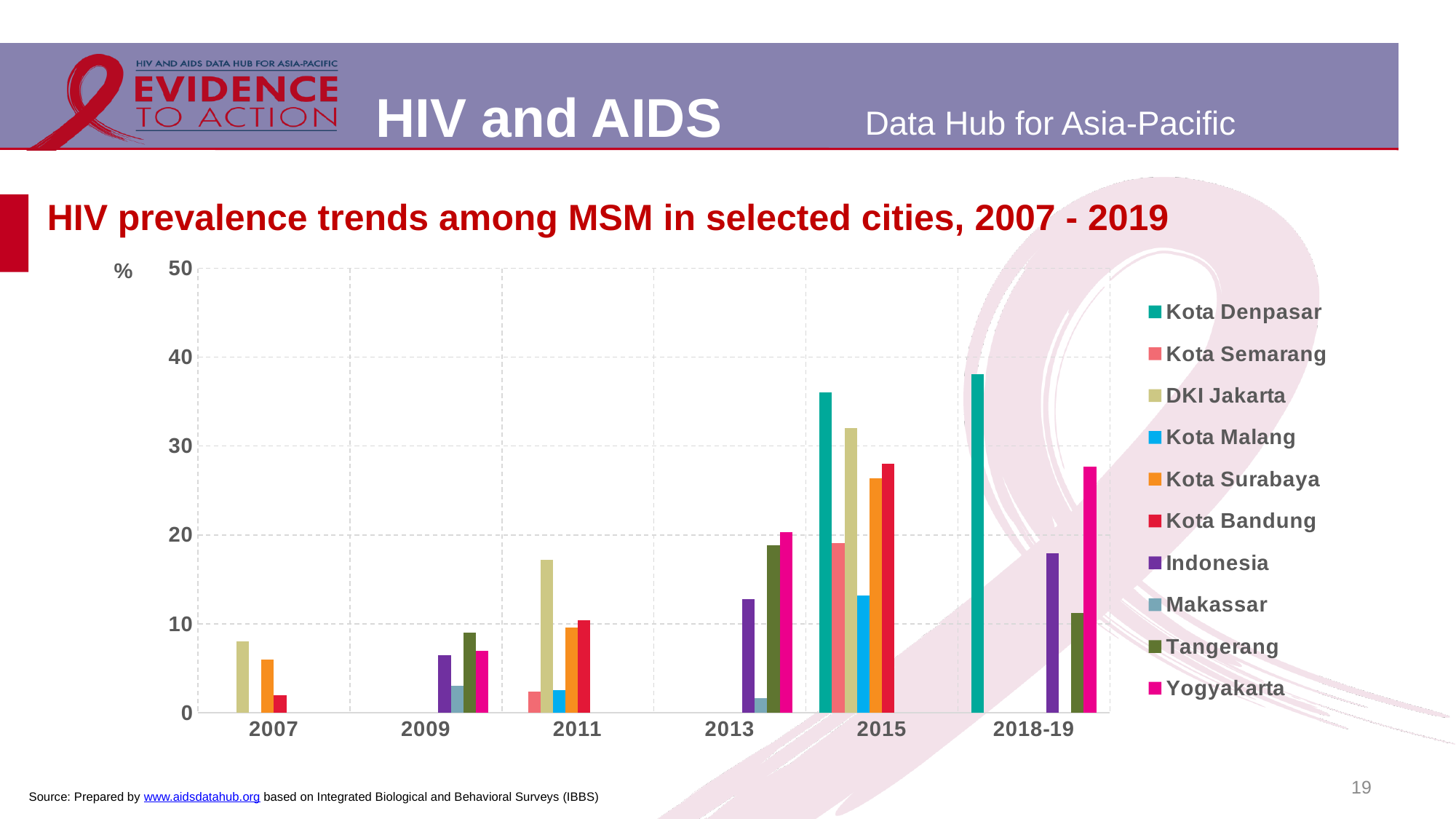
What kind of chart is shown on the slide? Bar chart Does the value for Kota Denpasar rise or fall from 2015 to 2018-19? Rise Is the value for DKI Jakarta in 2011 greater or less than 10? greater Is the value for Kota Malang in 2015 greater or less than 20? less Which city has the highest HIV prevalence in 2015? Kota Denpasar What is the title of the chart? HIV prevalence trends among MSM in selected cities, 2007 - 2019 Which series has the lowest value in 2013? Makassar How many series does the legend list? 10 How many year categories are shown on the x axis? 6 What unit is shown on the y axis of the chart? % Is the value for Kota Denpasar in 2015 greater or less than 30? greater In 2015, which is larger: DKI Jakarta or Kota Surabaya? DKI Jakarta